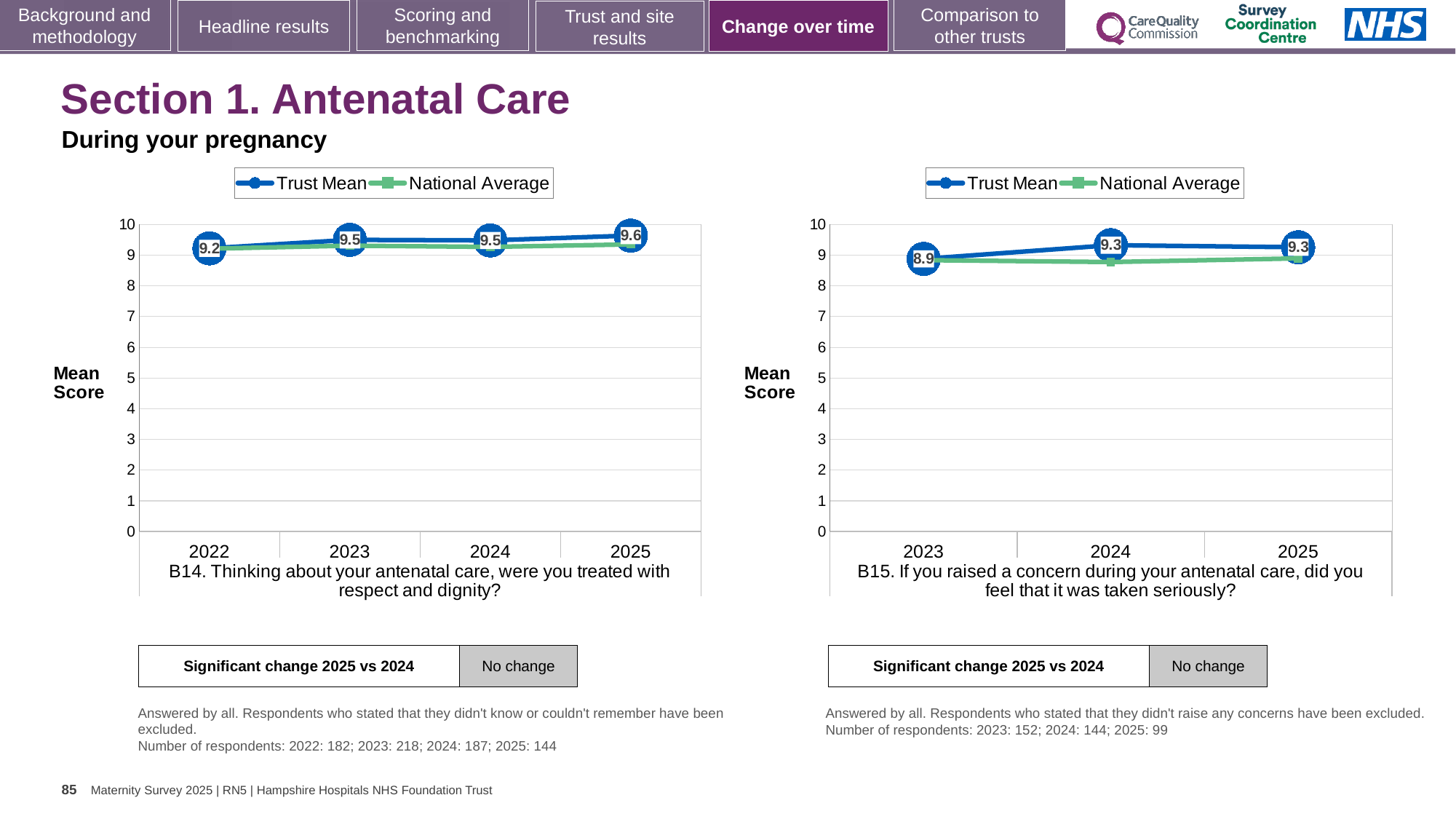
How many series does the legend of the right chart (B15) list? 2 On the left chart (B14), what is the Trust Mean score for 2025? 9.6 On the right chart (B15), what is the Trust Mean score for 2025? 9.3 How many years are shown on the x axis of the left chart (B14)? 4 On the right chart (B15), what is the Trust Mean score for 2023? 8.9 On the right chart (B15), is the National Average value for 2024 greater or less than 8? greater On the right chart (B15), which year has the lowest Trust Mean score? 2023 What type of chart is used for the left chart (B14)? Line chart On the left chart (B14), what is the difference between the Trust Mean scores for 2025 and 2022? 0.4 On the left chart (B14), what is the Trust Mean score for 2022? 9.2 On the right chart (B15), is the Trust Mean score higher in 2023 or 2024? 2024 On the left chart (B14), which year has the highest Trust Mean score? 2025